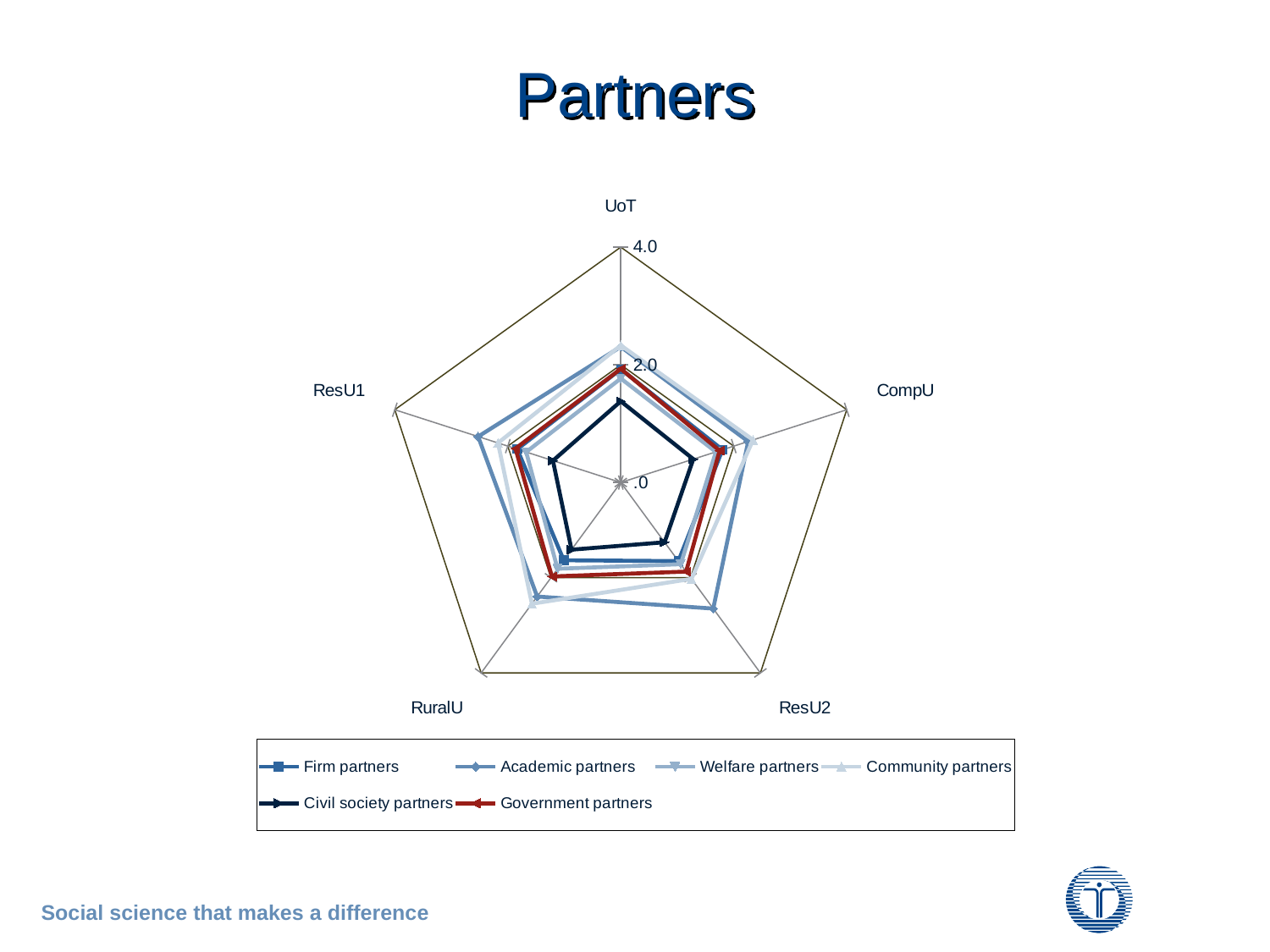
What is the title of the slide containing the chart? Partners Which series has the lowest value at UoT? Civil society partners How many categories (axes) does the radar chart have? 5 Is the value for Academic partners at ResU1 greater or less than 2.0? greater Which series is drawn in red in the chart? Government partners At ResU2, which is larger: the value for Academic partners or the value for Civil society partners? Academic partners Is the value for Civil society partners at CompU greater or less than 2.0? less What kind of chart is shown on the slide? radar chart How many series does the legend list? 6 Which series has the highest value at ResU2? Academic partners Is the value for Academic partners at ResU2 greater or less than 2.0? greater